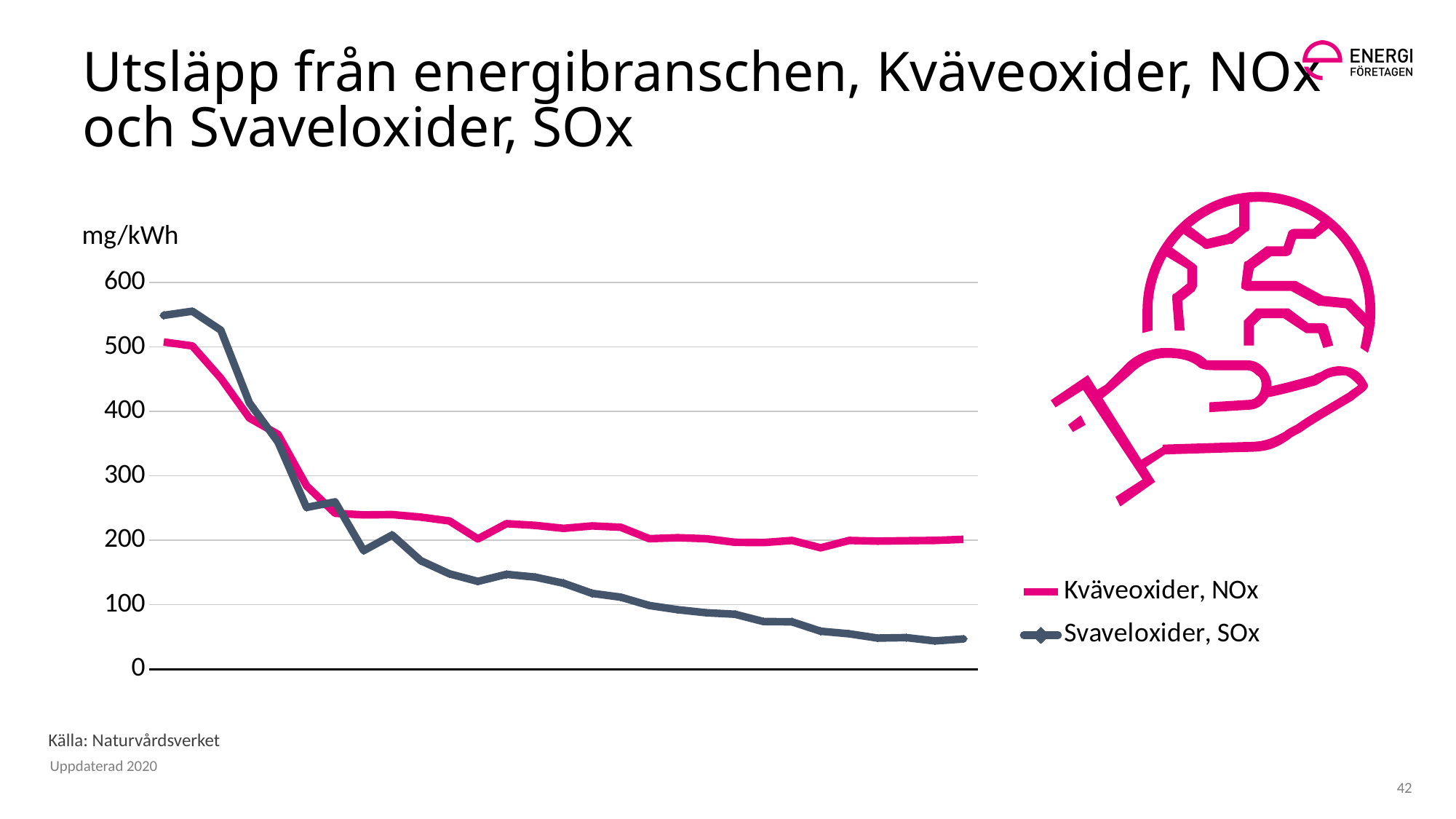
At the end of the series, which is higher: Kväveoxider, NOx or Svaveloxider, SOx? Kväveoxider, NOx Is the final value of Svaveloxider, SOx greater or less than 100? less At the start of the series, which is higher: Kväveoxider, NOx or Svaveloxider, SOx? Svaveloxider, SOx Which two series are shown in the legend? Kväveoxider, NOx and Svaveloxider, SOx Is the highest value of Svaveloxider, SOx greater or less than 500? greater What kind of chart is shown on the slide? line chart What unit is shown on the y axis of the chart? mg/kWh Does the Svaveloxider, SOx series rise or fall overall along the x axis? fall Is the final value of Kväveoxider, NOx greater or less than 100? greater How many series does the legend list? 2 Does the Kväveoxider, NOx series rise or fall overall along the x axis? fall